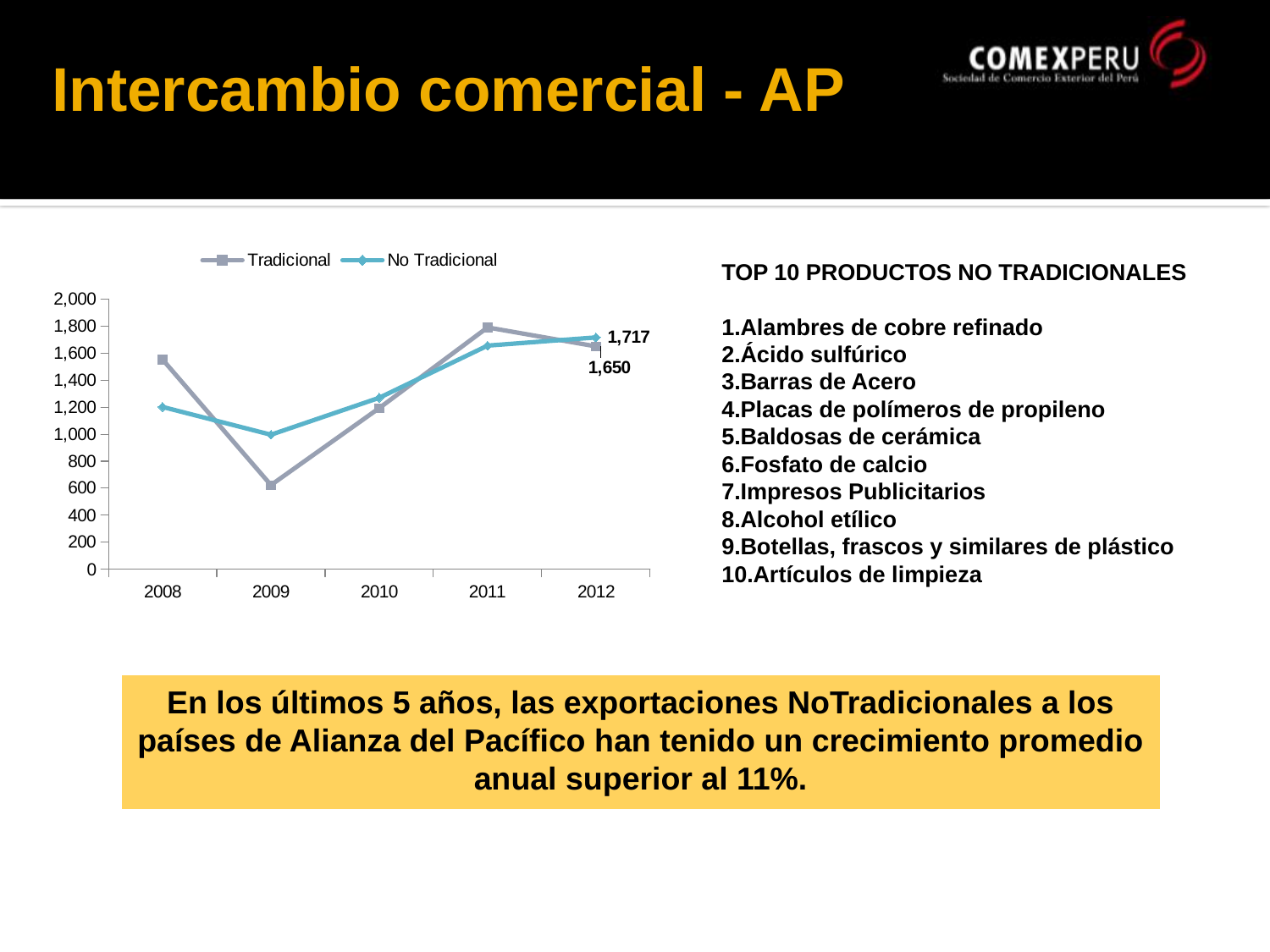
What is the difference between the No Tradicional and Tradicional values in 2012? 67 What is the value of the Tradicional series in 2012? 1,650 Is the value for No Tradicional in 2008 greater or less than 1,000? greater How many years are plotted on the x axis of the chart? 5 In 2012, which series has the larger value, Tradicional or No Tradicional? No Tradicional What kind of chart is shown on the slide? Line chart In which year does the Tradicional series reach its highest value? 2011 In which year does the Tradicional series reach its lowest value? 2009 Is the value for Tradicional in 2009 greater or less than 800? less What is the value of the No Tradicional series in 2012? 1,717 In 2009, which series has the larger value, Tradicional or No Tradicional? No Tradicional How many series does the chart legend list? 2